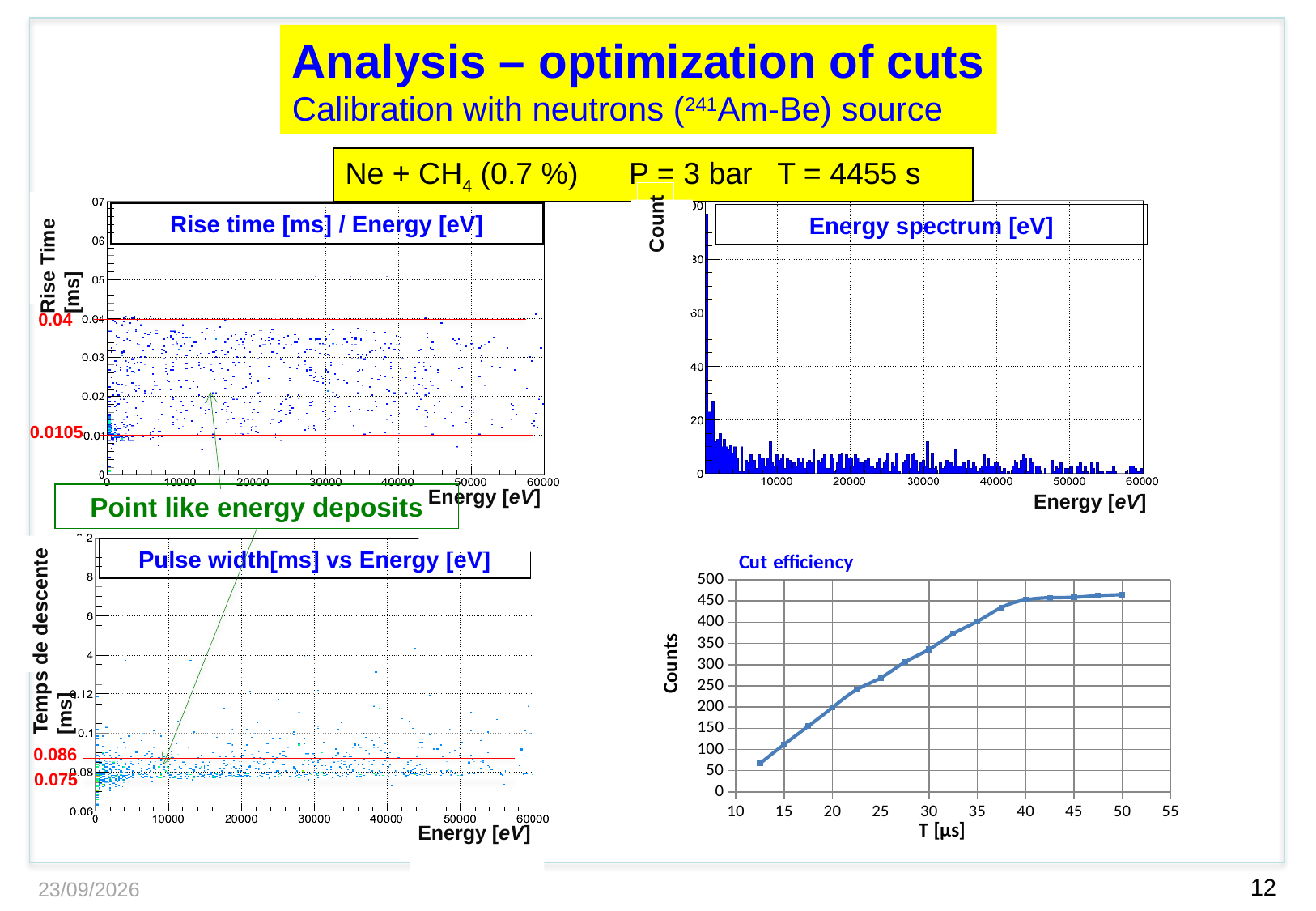
In the 'Energy spectrum [eV]' chart, is the count in the highest bin greater or less than 60? greater In the 'Rise time [ms] / Energy [eV]' chart, what is the lower red cut value marked on the rise time axis? 0.0105 In the 'Cut efficiency' chart, is the value at T = 35 µs greater or less than 350? greater What kind of chart is the 'Cut efficiency' chart? line chart In the 'Cut efficiency' chart, is the value at T = 50 µs greater or less than 450? greater In the 'Cut efficiency' chart, which is larger: the value at T = 30 µs or the value at T = 40 µs? T = 40 µs What is the x-axis label of the 'Cut efficiency' chart? T [µs] In the 'Cut efficiency' chart, do the counts rise or fall as T increases? rise In the 'Pulse width[ms] vs Energy [eV]' chart, what is the difference between the two red cut values 0.086 and 0.075? 0.011 In the 'Rise time [ms] / Energy [eV]' chart, what is the upper red cut value marked on the rise time axis? 0.04